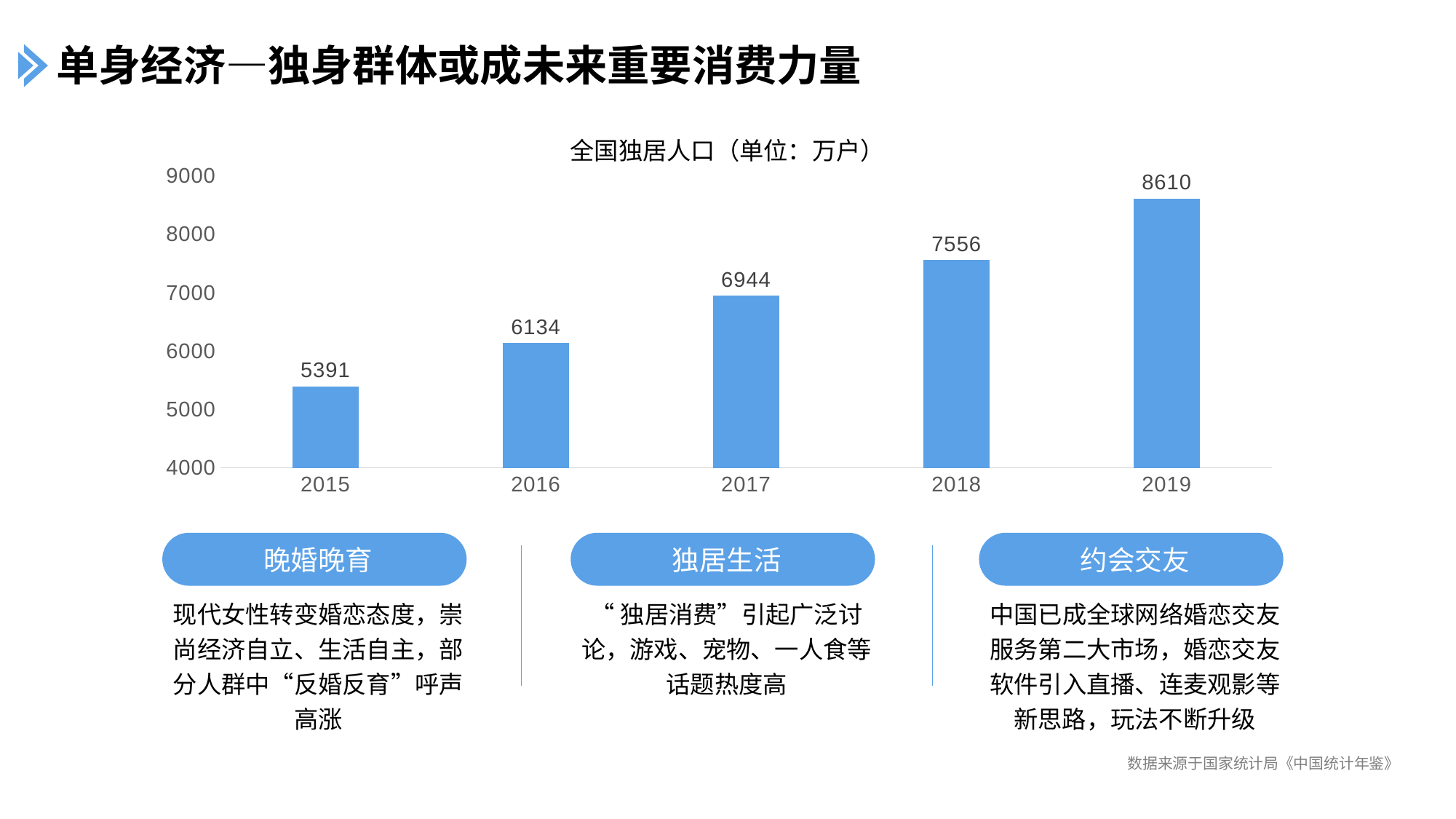
Do the values rise or fall from 2015 to 2019? rise What is the value for 2015? 5391 Which year has the highest value? 2019 Which is larger, the value for 2017 or the value for 2016? 2017 Which year has the lowest value? 2015 What kind of chart is shown on the slide? bar chart How many years are shown on the x axis? 5 What is the difference between the values for 2019 and 2018? 1054 What is the value for 2019? 8610 What is the difference between the values for 2016 and 2015? 743 What is the value for 2017? 6944 Is the value for 2018 greater or less than 7000? greater